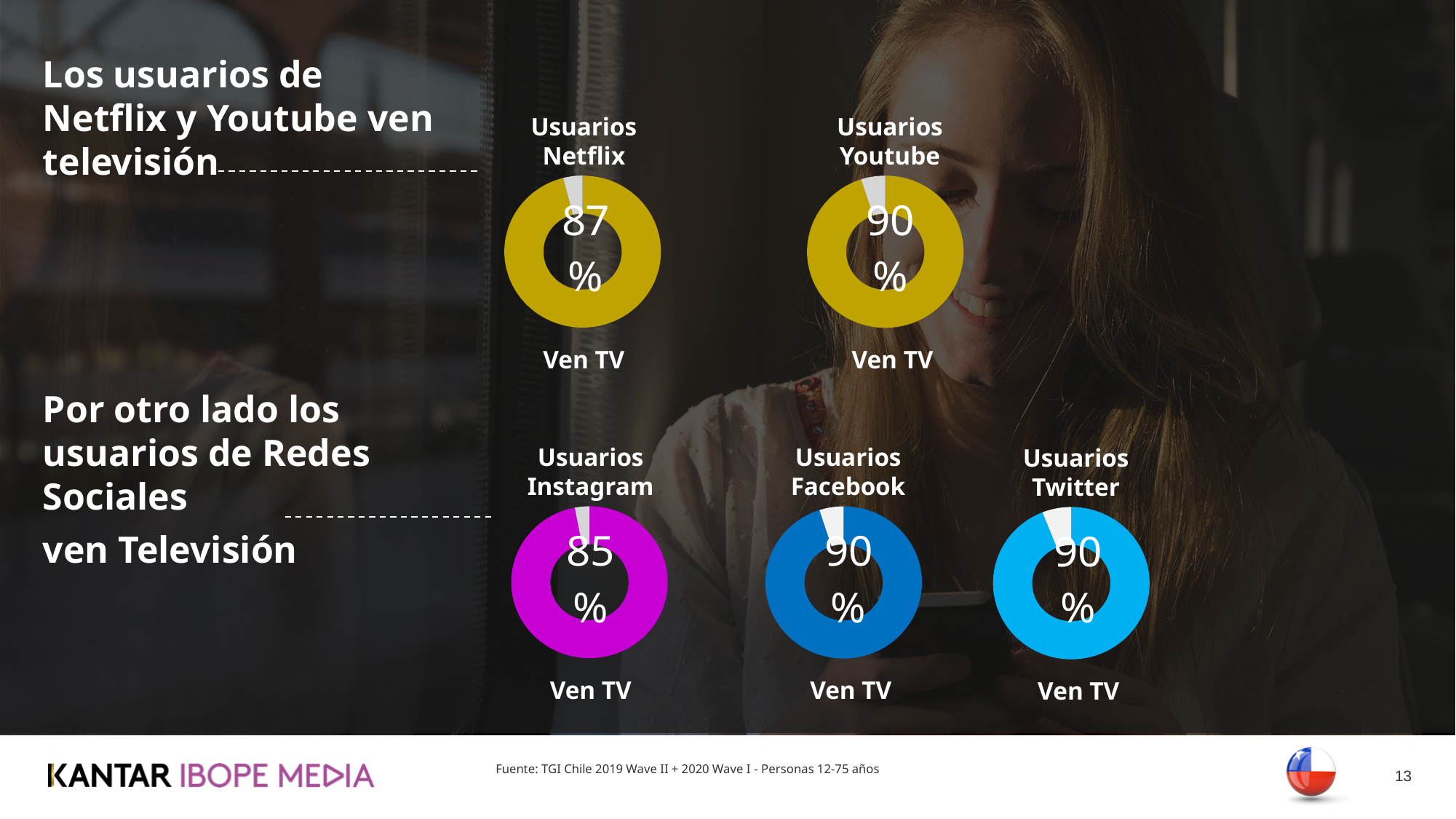
In the Usuarios Netflix chart, what percentage of users watch TV (Ven TV)? 87% In the Usuarios Twitter chart, what percentage of users watch TV (Ven TV)? 90% Across the five charts on the slide, which user group has the lowest share that watches TV? Usuarios Instagram What colour is the Usuarios Instagram donut chart? Magenta In the Usuarios Facebook chart, what percentage of users watch TV (Ven TV)? 90% In the Usuarios Youtube chart, what percentage of users watch TV (Ven TV)? 90% What is the difference between the Ven TV share in the Usuarios Youtube chart and the Usuarios Netflix chart? 3% How many donut charts are shown on the slide? 5 Which is larger: the Ven TV share in the Usuarios Netflix chart or in the Usuarios Instagram chart? Usuarios Netflix What type of chart is used for the Usuarios Netflix chart? Donut chart In the Usuarios Instagram chart, what percentage of users watch TV (Ven TV)? 85% What is the difference between the Ven TV share in the Usuarios Facebook chart and the Usuarios Instagram chart? 5%